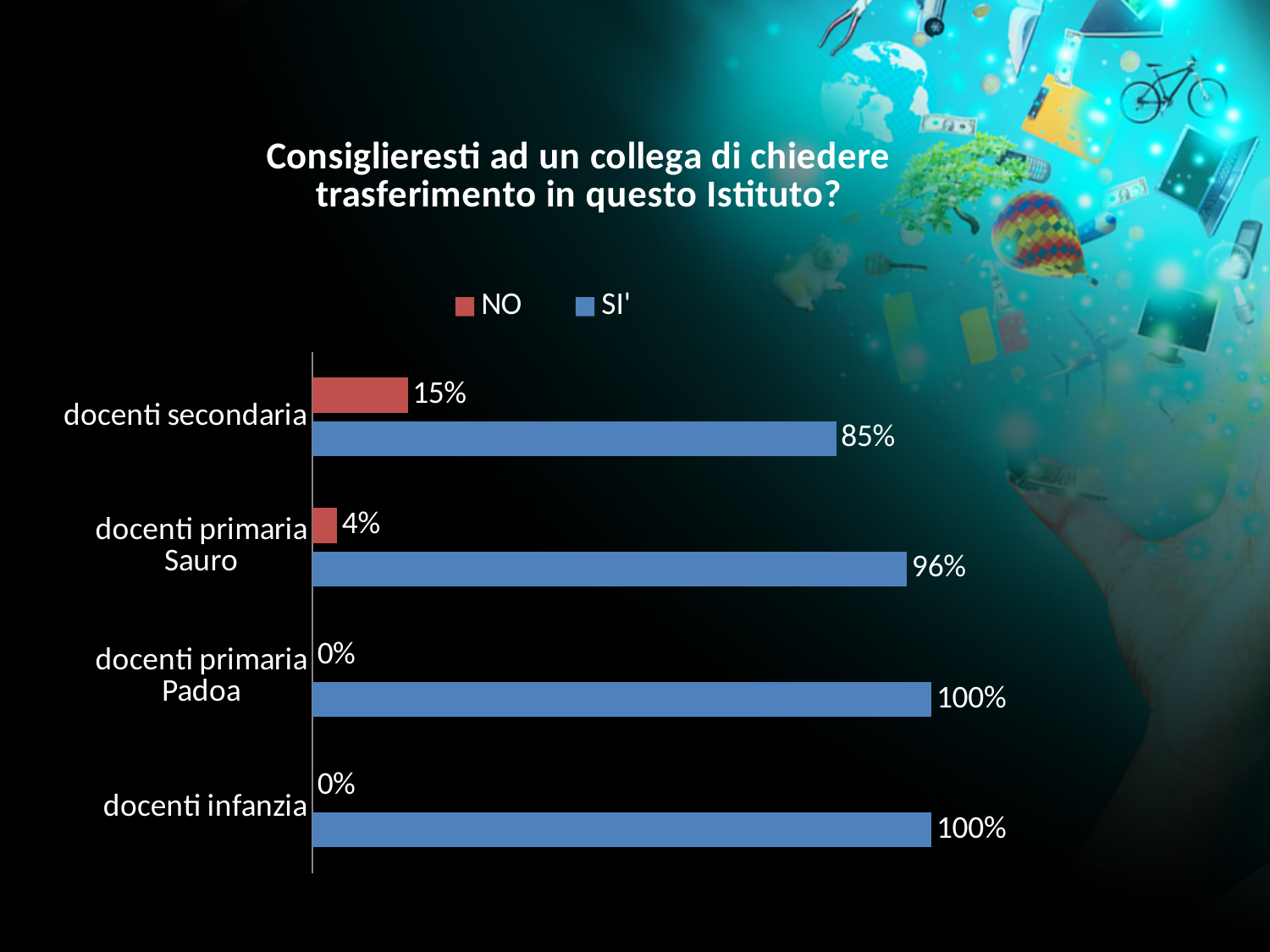
Which category has the highest NO value? docenti secondaria Which is larger, the NO value for docenti secondaria or the NO value for docenti primaria Sauro? docenti secondaria What is the NO value for docenti infanzia? 0% How many series does the legend list? 2 How many categories are shown on the chart? 4 What kind of chart is shown on the slide? bar chart What is the SI' value for docenti secondaria? 85% Which category has the lowest SI' value? docenti secondaria What is the difference between the SI' values for docenti primaria Sauro and docenti secondaria? 11% What is the NO value for docenti primaria Sauro? 4% What is the SI' value for docenti primaria Padoa? 100% What is the difference between the SI' and NO values for docenti secondaria? 70%